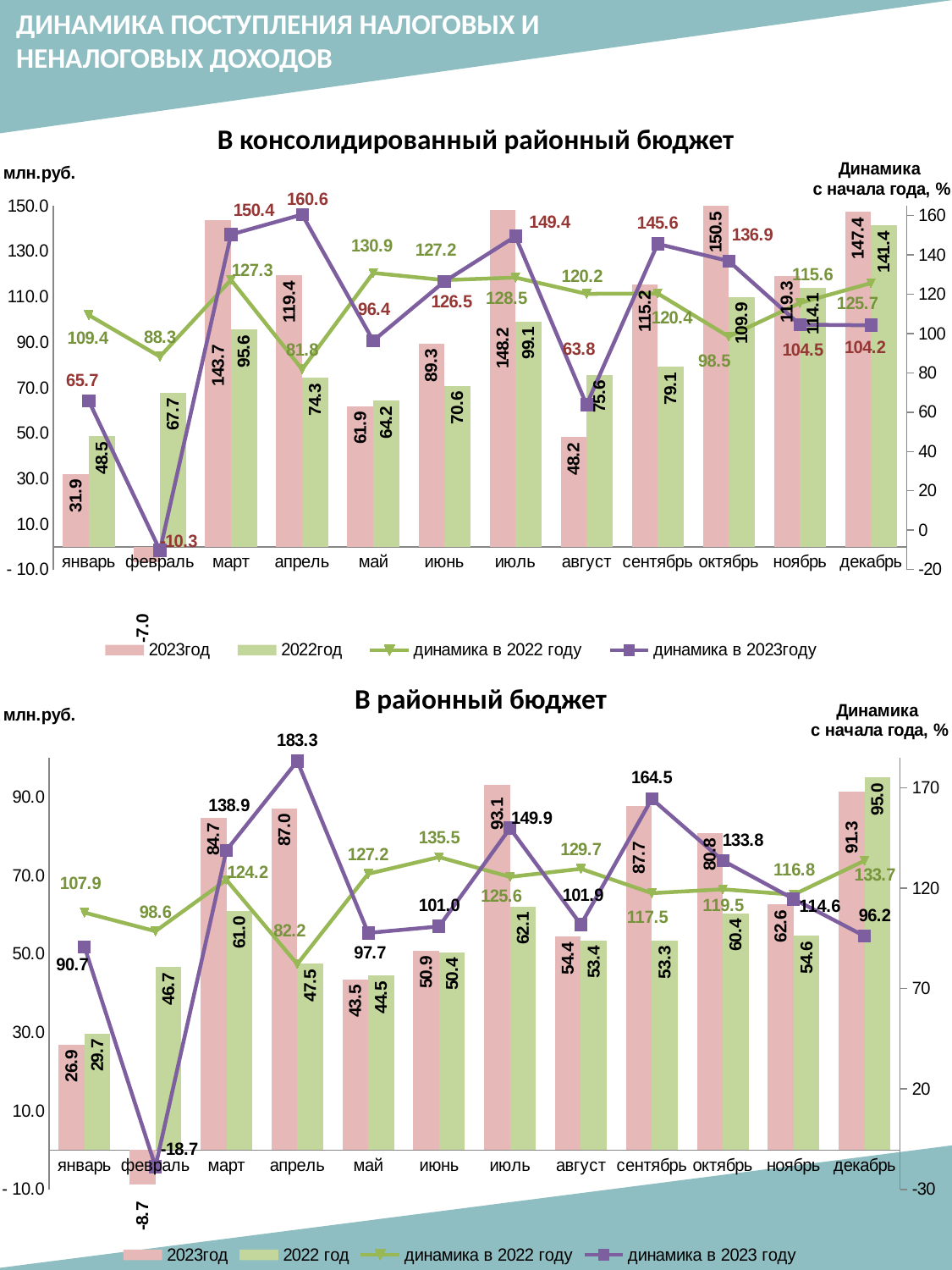
What kind of chart is 'В районный бюджет'? Combined bar and line chart On the chart 'В районный бюджет', which month has the highest 'динамика в 2023 году' value? апрель On the chart 'В консолидированный районный бюджет', what is the value of the 2023год bar for октябрь? 150.5 On the chart 'В районный бюджет', what is the value of the 2022 год bar for декабрь? 95.0 On the chart 'В консолидированный районный бюджет', what is the value of 'динамика в 2023году' for апрель? 160.6 On the chart 'В консолидированный районный бюджет', which month has the highest 2023год bar? октябрь On the chart 'В районный бюджет', how many months are shown on the x axis? 12 On the chart 'В районный бюджет', which is larger for июль: the 2023год bar or the 2022 год bar? 2023год On the chart 'В консолидированный районный бюджет', what is the difference between the 2023год and 2022год values for март? 48.1 On the chart 'В консолидированный районный бюджет', which month has the lowest 2023год value? февраль On the chart 'В консолидированный районный бюджет', how many series does the legend list? 4 On the chart 'В районный бюджет', what is the value of 'динамика в 2022 году' for июнь? 135.5